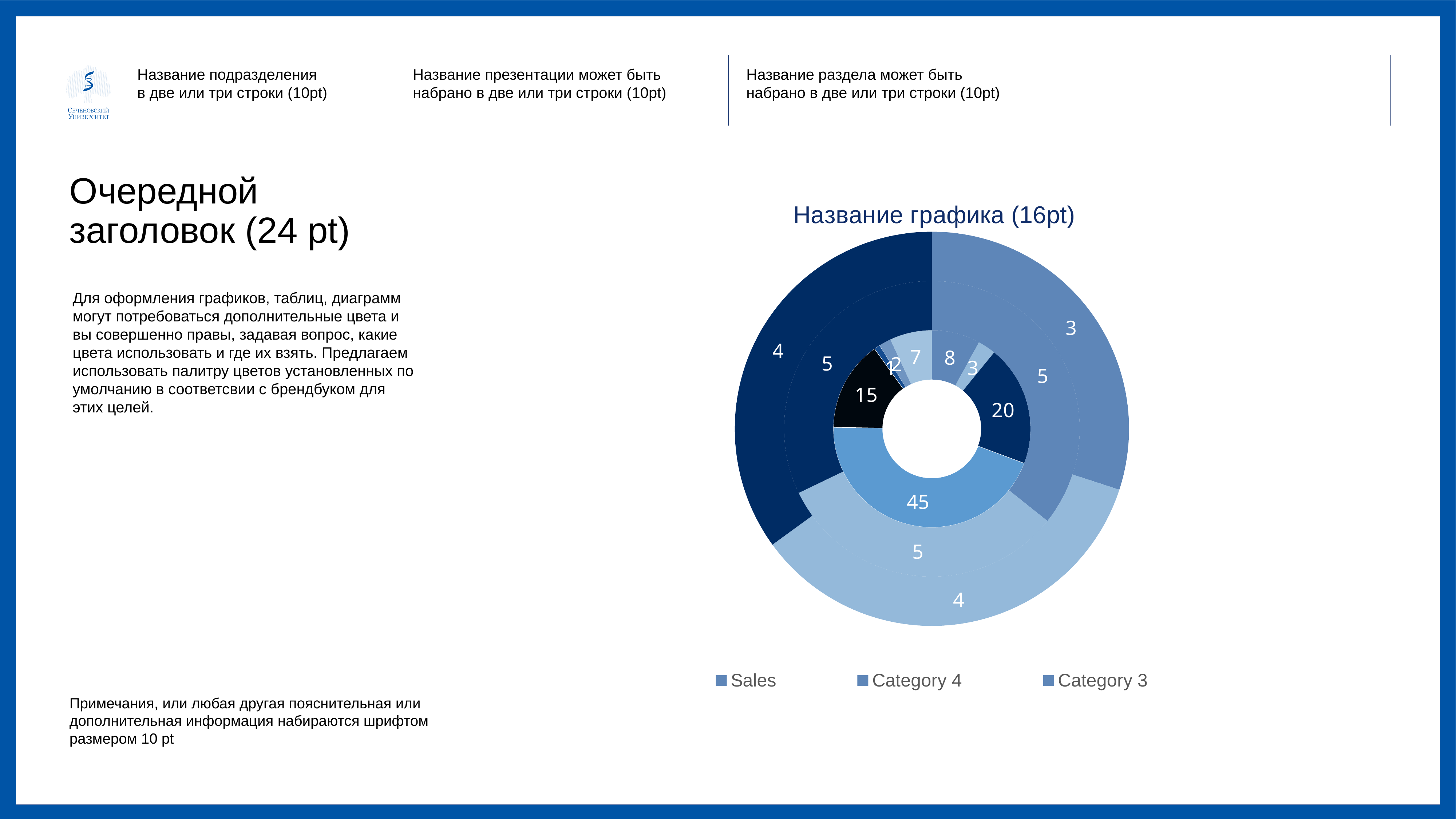
What is the title of the chart? Название графика (16pt) How many series does the legend list? 3 What is the sum of all the values labelled in the innermost ring? 101 What kind of chart is shown on the slide? doughnut chart What are the three entries in the chart legend? Sales, Category 4, Category 3 How many rings does the doughnut chart have? 3 What is the smallest value labelled in the innermost ring of the doughnut? 1 What is the difference between the two largest values in the innermost ring (45 and 20)? 25 How many slices are labelled in the innermost ring of the doughnut? 8 What is the largest value labelled in the innermost ring of the doughnut? 45 In the innermost ring, which is larger: the slice labelled 20 or the slice labelled 15? 20